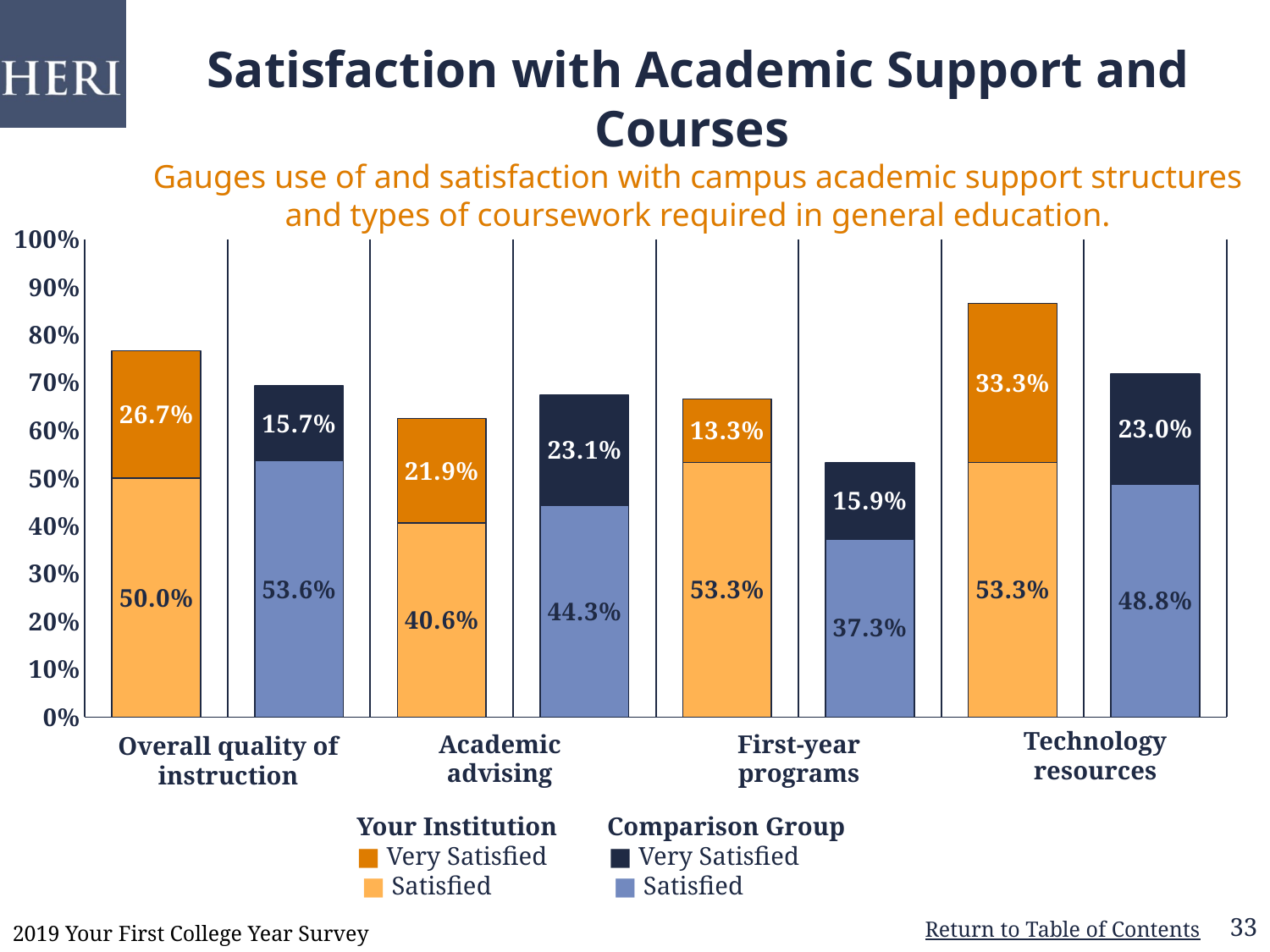
What is the total of the Comparison Group stacked bar for Overall quality of instruction? 69.3% What percentage of Your Institution respondents were Very Satisfied with Technology resources? 33.3% What type of chart is shown on the slide? Stacked bar chart Which category has the highest Your Institution Very Satisfied value? Technology resources For Academic advising, which is larger: the Your Institution Satisfied value or the Comparison Group Satisfied value? Comparison Group Satisfied What is the total of the Your Institution stacked bar for Technology resources? 86.6% Which category has the lowest Comparison Group Satisfied value? First-year programs How many series does the legend list? 4 What percentage of Your Institution respondents were Satisfied with Academic advising? 40.6% What is the difference between the Your Institution and Comparison Group Very Satisfied values for Overall quality of instruction? 11.0% How many categories are shown on the x axis? 4 What percentage of the Comparison Group were Satisfied with First-year programs? 37.3%